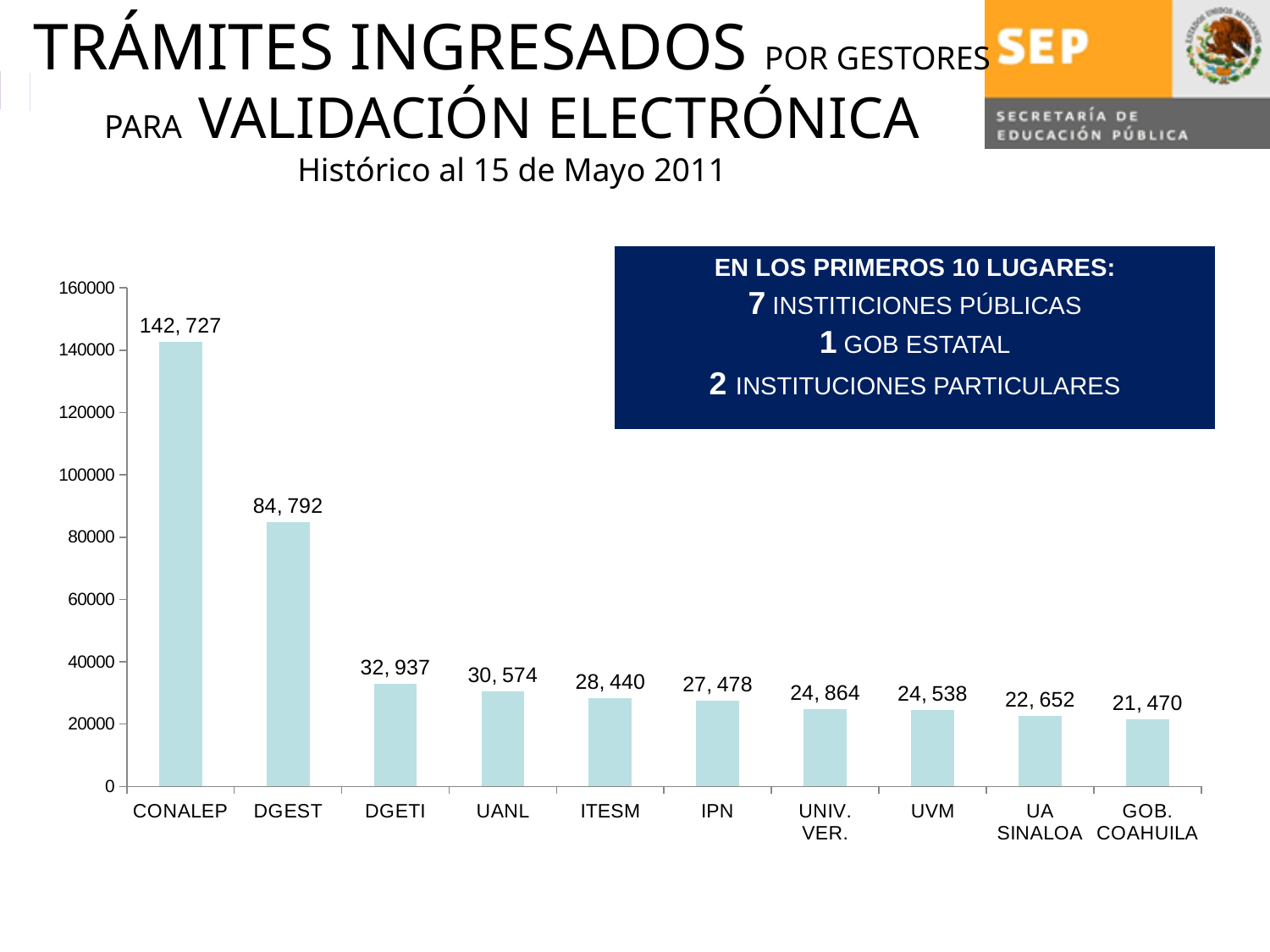
What is the value for UANL? 30, 574 Which category has the lowest value? GOB. COAHUILA What is the value for CONALEP? 142, 727 How many categories are shown on the x axis? 10 What kind of chart is shown on the slide? bar chart Which category has the highest value? CONALEP Which is larger, the value for DGETI or the value for IPN? DGETI What is the value for GOB. COAHUILA? 21, 470 Is the value for DGEST greater or less than 80000? greater What is the value for DGEST? 84, 792 What is the difference between the values for CONALEP and DGEST? 57, 935 Do the values rise or fall from left to right along the x axis? fall